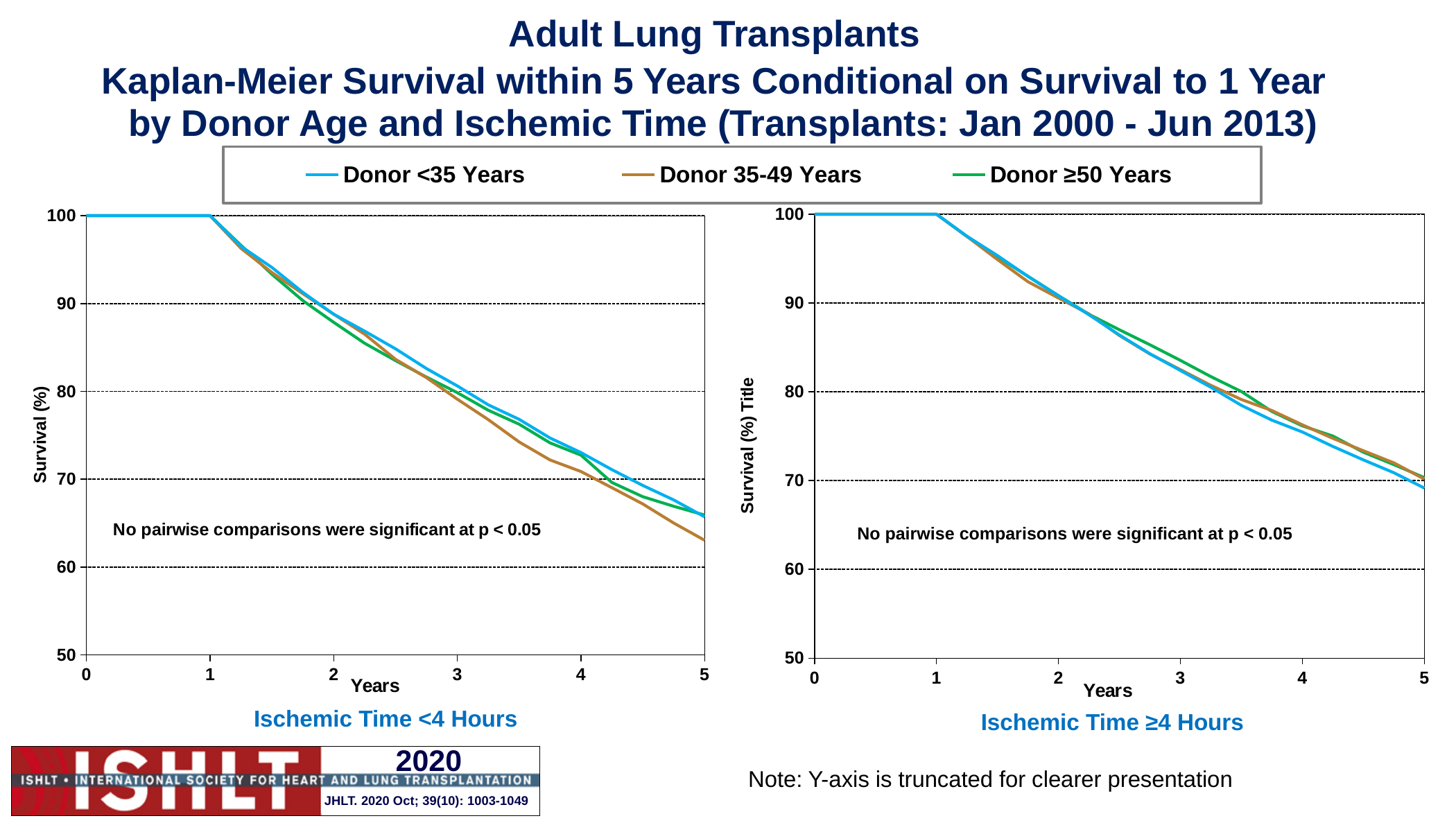
What is the label of the y-axis on the Ischemic Time <4 Hours chart? Survival (%) In the Ischemic Time <4 Hours chart, at year 5, which is larger: the value for Donor <35 Years or for Donor 35-49 Years? Donor <35 Years How many series does the legend list for the charts on this slide? 3 What colour is the line for Donor ≥50 Years in the legend? green In the Ischemic Time <4 Hours chart, is the value for Donor 35-49 Years at year 5 greater or less than 70? less In the Ischemic Time <4 Hours chart, which series has the lowest survival at year 5? Donor 35-49 Years In the Ischemic Time ≥4 Hours chart, what is the survival value for Donor ≥50 Years at year 1? 100 In the Ischemic Time ≥4 Hours chart, is the value for Donor <35 Years at year 3 greater or less than 80? greater In the Ischemic Time <4 Hours chart, what is the survival value for Donor <35 Years at year 1? 100 In the Ischemic Time <4 Hours chart, do the survival values rise or fall from year 1 to year 5? fall What type of chart is shown on the left of the slide (Ischemic Time <4 Hours)? line chart In the Ischemic Time ≥4 Hours chart, is the value for Donor 35-49 Years at year 4 greater or less than 80? less